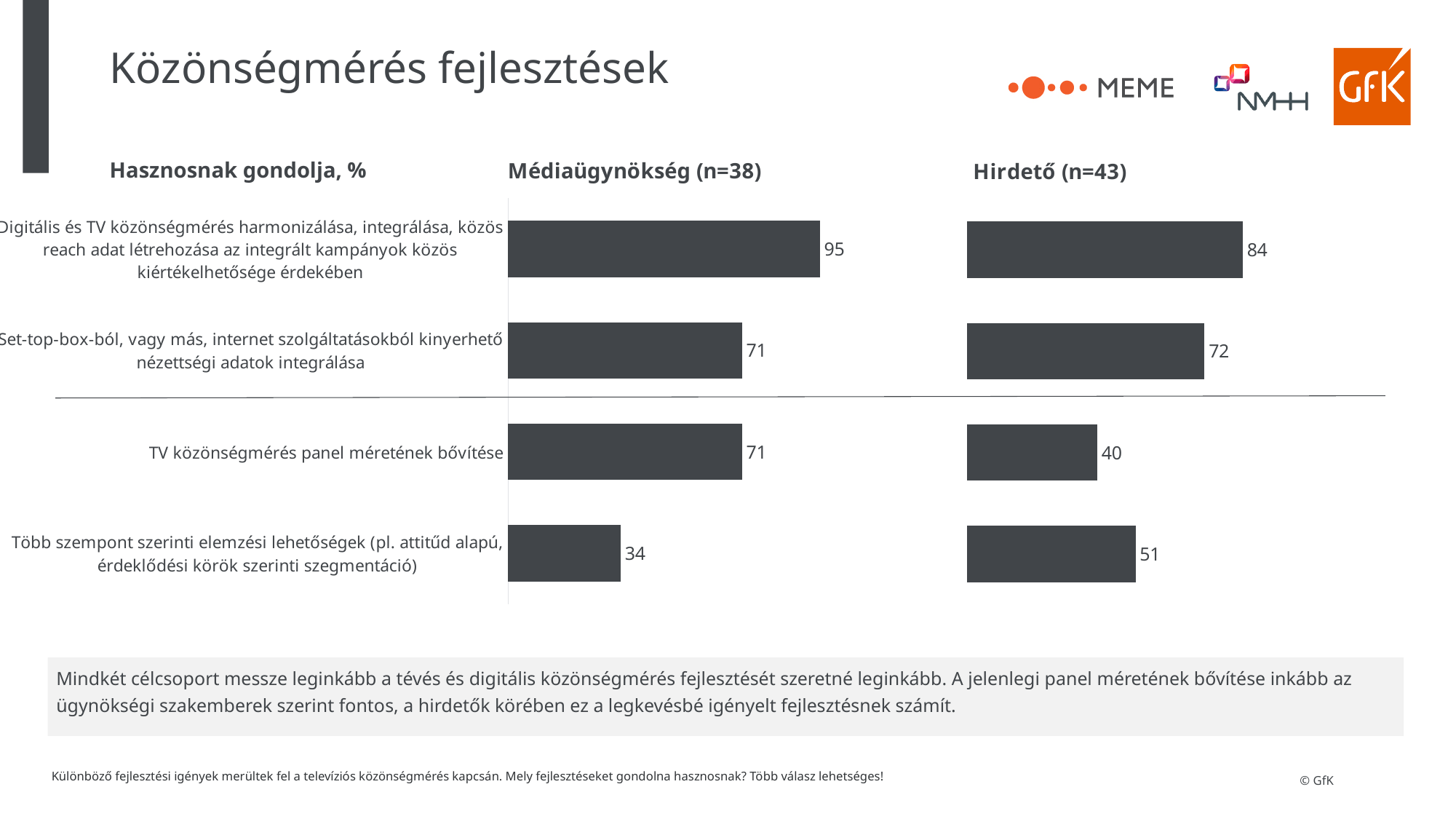
In the Médiaügynökség (n=38) chart, which category has the highest value? Digitális és TV közönségmérés harmonizálása, integrálása, közös reach adat létrehozása az integrált kampányok közös kiértékelhetősége érdekében In the Hirdető (n=43) chart, what is the value for 'Set-top-box-ból, vagy más, internet szolgáltatásokból kinyerhető nézettségi adatok integrálása'? 72 In the Hirdető (n=43) chart, what is the value for 'Több szempont szerinti elemzési lehetőségek (pl. attitűd alapú, érdeklődési körök szerinti szegmentáció)'? 51 In the Médiaügynökség (n=38) chart, what is the value for 'TV közönségmérés panel méretének bővítése'? 71 How many categories are shown in the Hirdető (n=43) chart? 4 What is the difference between the Médiaügynökség (n=38) value and the Hirdető (n=43) value for 'Digitális és TV közönségmérés harmonizálása, integrálása, közös reach adat létrehozása az integrált kampányok közös kiértékelhetősége érdekében'? 11 In the Hirdető (n=43) chart, which category has the lowest value? TV közönségmérés panel méretének bővítése What is the title of the slide? Közönségmérés fejlesztések In the Médiaügynökség (n=38) chart, which category has the lowest value? Több szempont szerinti elemzési lehetőségek (pl. attitűd alapú, érdeklődési körök szerinti szegmentáció) What is the difference between the Médiaügynökség (n=38) value and the Hirdető (n=43) value for 'TV közönségmérés panel méretének bővítése'? 31 For 'Több szempont szerinti elemzési lehetőségek (pl. attitűd alapú, érdeklődési körök szerinti szegmentáció)', which chart shows the larger value, Médiaügynökség (n=38) or Hirdető (n=43)? Hirdető (n=43) What kind of chart is the Médiaügynökség (n=38) chart? Bar chart